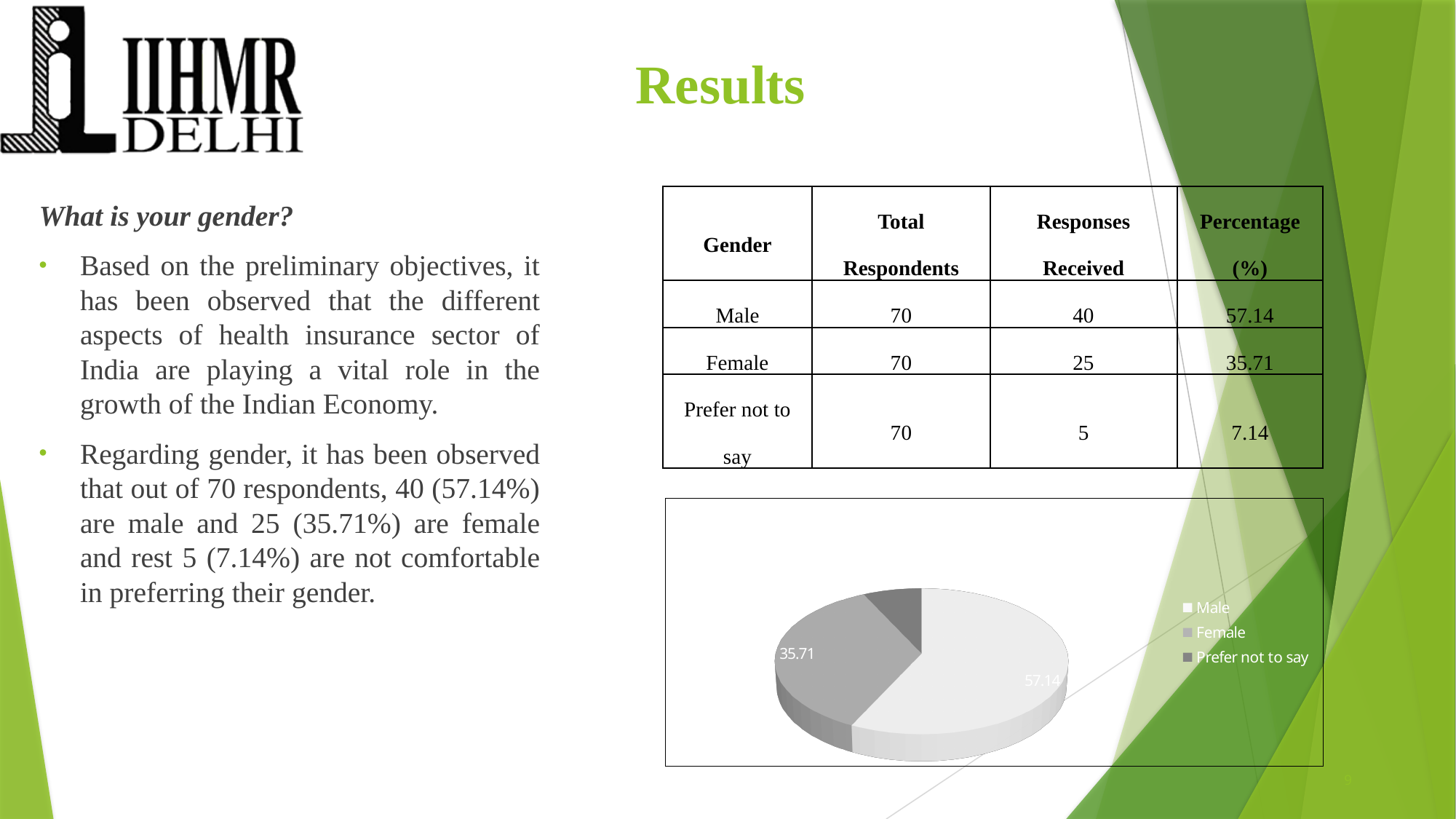
Which slice of the pie chart is the smallest? Prefer not to say What kind of chart is shown on the slide? pie chart How many entries does the pie chart's legend list? 3 Is the Male slice of the pie chart greater or less than half of the pie? greater What are the three legend entries of the pie chart, in order? Male, Female, Prefer not to say How many slices does the pie chart have? 3 What value is labelled on the Male slice of the pie chart? 57.14 Which legend entry of the pie chart has no value label shown on its slice? Prefer not to say Which slice of the pie chart is the largest? Male What is the difference between the Male and Female values labelled on the pie chart? 21.43 Which is larger in the pie chart, the Male slice or the Female slice? Male What value is labelled on the Female slice of the pie chart? 35.71